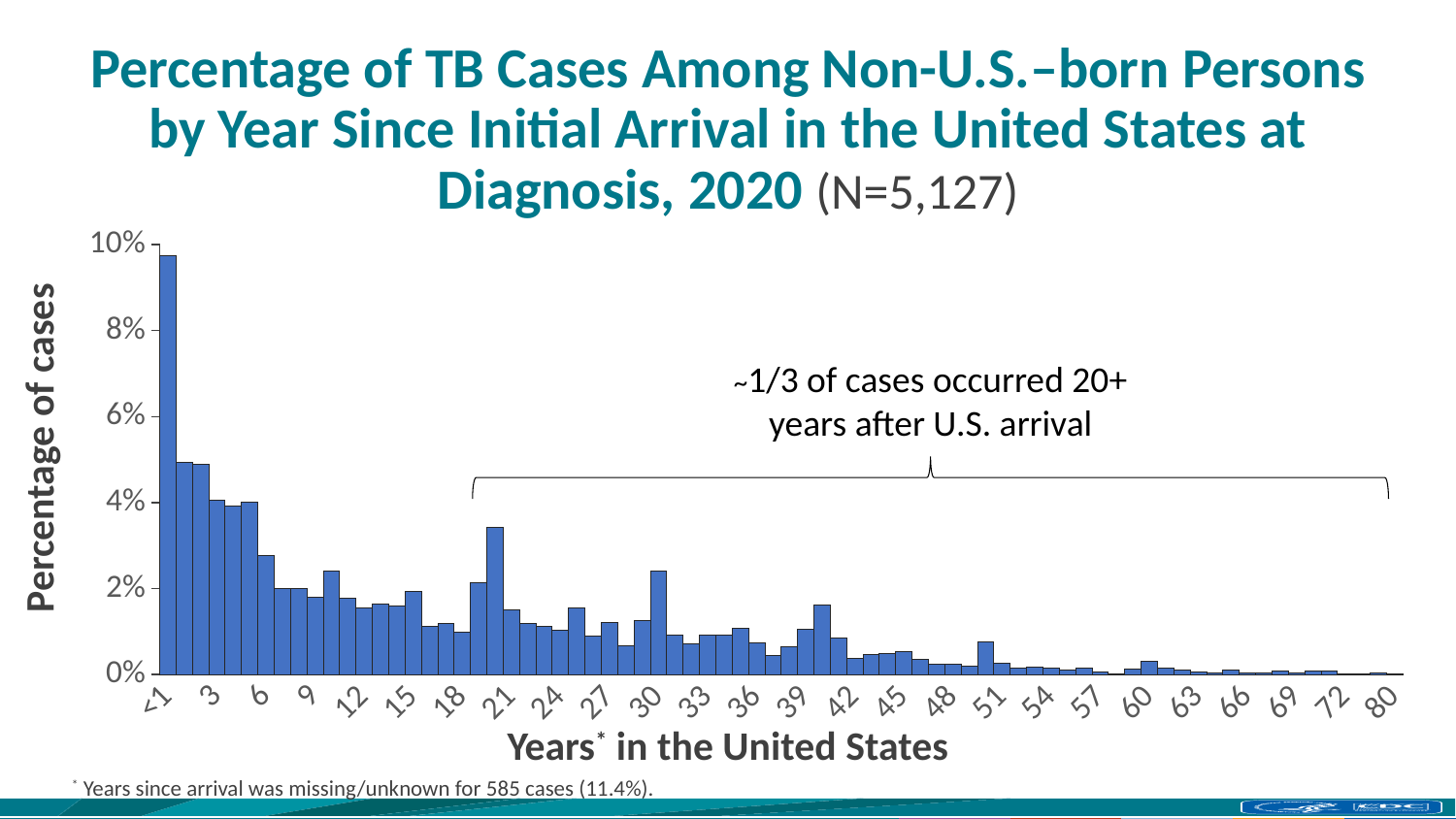
Is the value for 21 greater or less than 4%? less Which is larger, the value for <1 or the value for 3? <1 Which category has the highest percentage of cases? <1 Do the values generally rise or fall as years in the United States increase? fall Is the value for 60 greater or less than 2%? less Is the value for <1 greater or less than 8%? greater What kind of chart is shown on the slide? bar chart Which is larger, the value for 21 or the value for 24? 21 According to the annotation on the chart, what share of cases occurred 20+ years after U.S. arrival? ~1/3 What is the total number of cases (N) given in the chart title? 5,127